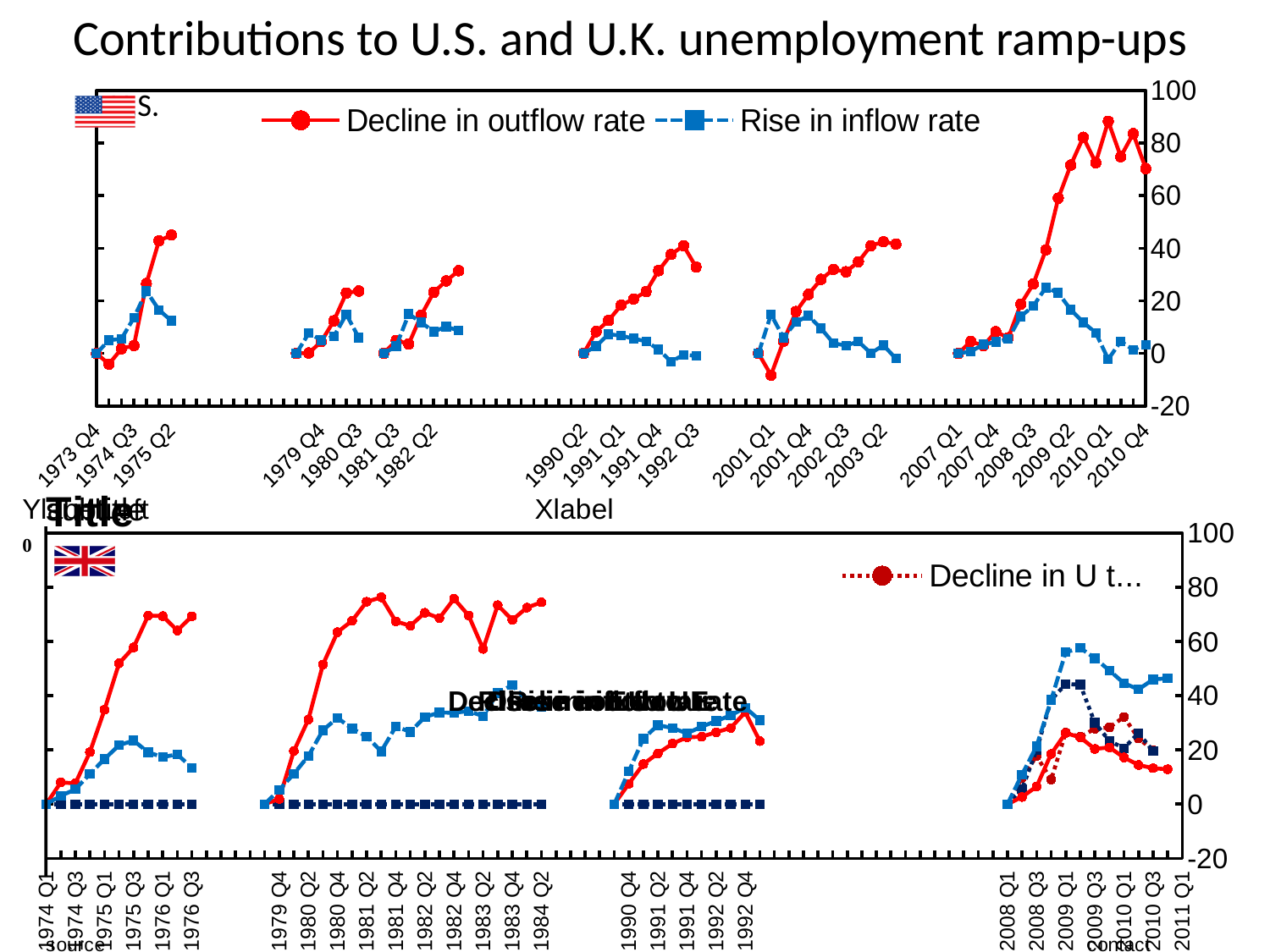
In the bottom (U.K.) chart, is the value of the blue dashed line at 2009 Q1 greater or less than 40? greater In the top (U.S.) chart, is the highest value of Decline in outflow rate greater or less than 80? greater How many series does the legend of the top (U.S.) chart list? 2 What are the two legend entries in the top (U.S.) chart? Decline in outflow rate; Rise in inflow rate In the top (U.S.) chart, is the value of Decline in outflow rate at 1975 Q2 greater or less than 20? greater In the top (U.S.) chart, does Decline in outflow rate rise or fall from 2007 Q1 to 2009 Q2? rise What kind of chart is the top (U.S.) chart? line chart What is the maximum value shown on the y axis of the top (U.S.) chart? 100 What kind of chart is the bottom (U.K.) chart? line chart In the top (U.S.) chart, which series is higher at 2009 Q2, Decline in outflow rate or Rise in inflow rate? Decline in outflow rate